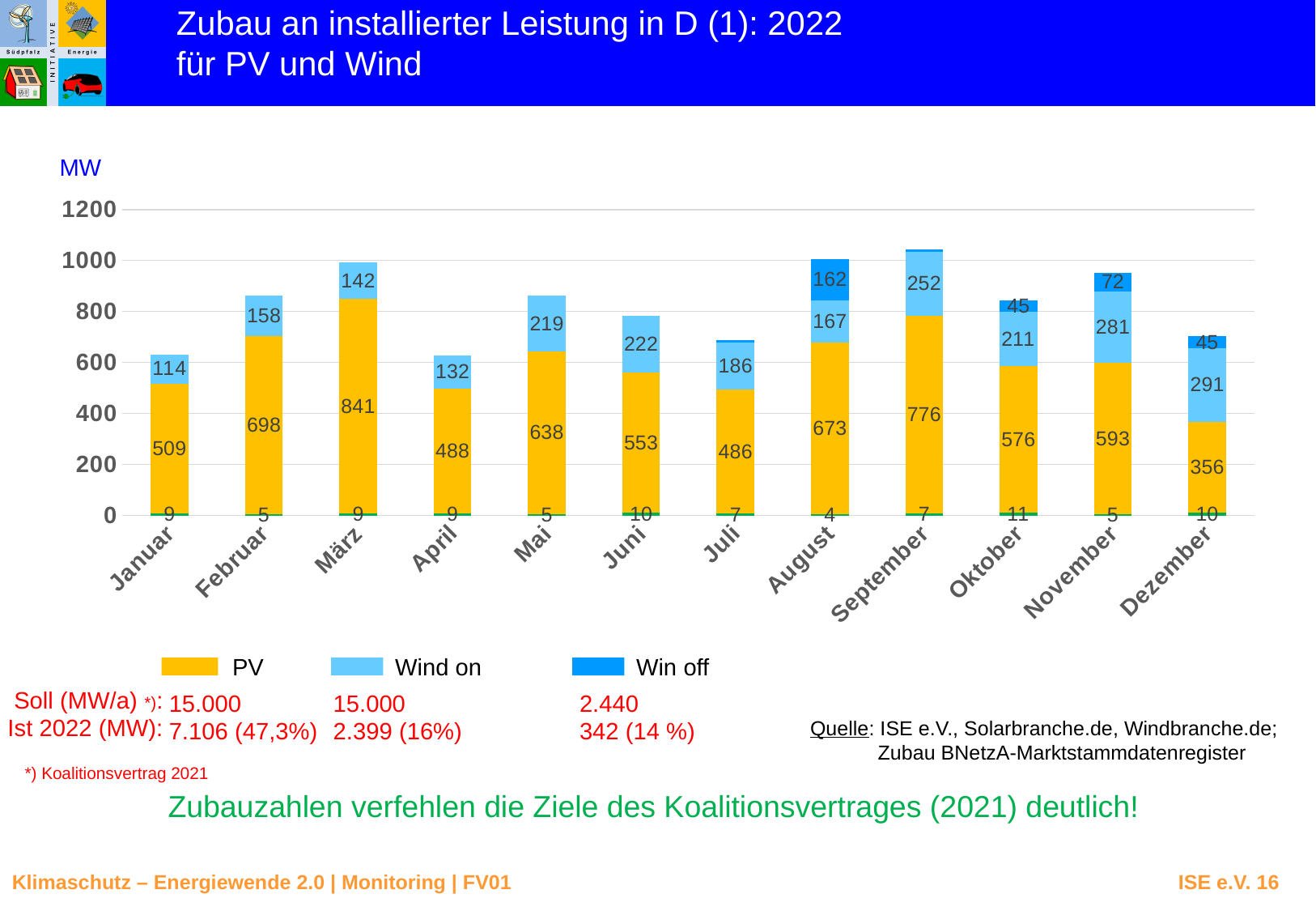
What kind of chart is shown on the slide? bar chart Which month has the lowest PV value? Dezember Which is larger, the PV value for Februar or the PV value for Mai? Februar How many series does the legend list? 3 How many months are shown on the x axis? 12 What is the difference between the PV value for März and the PV value for Dezember? 485 What is the Win off value for August? 162 What is the PV value for März? 841 Is the total height of the Dezember bar greater or less than 800? less What is the difference between the Wind on value for Dezember and the Wind on value for Januar? 177 What is the Wind on value for November? 281 Which month has the highest PV value? März